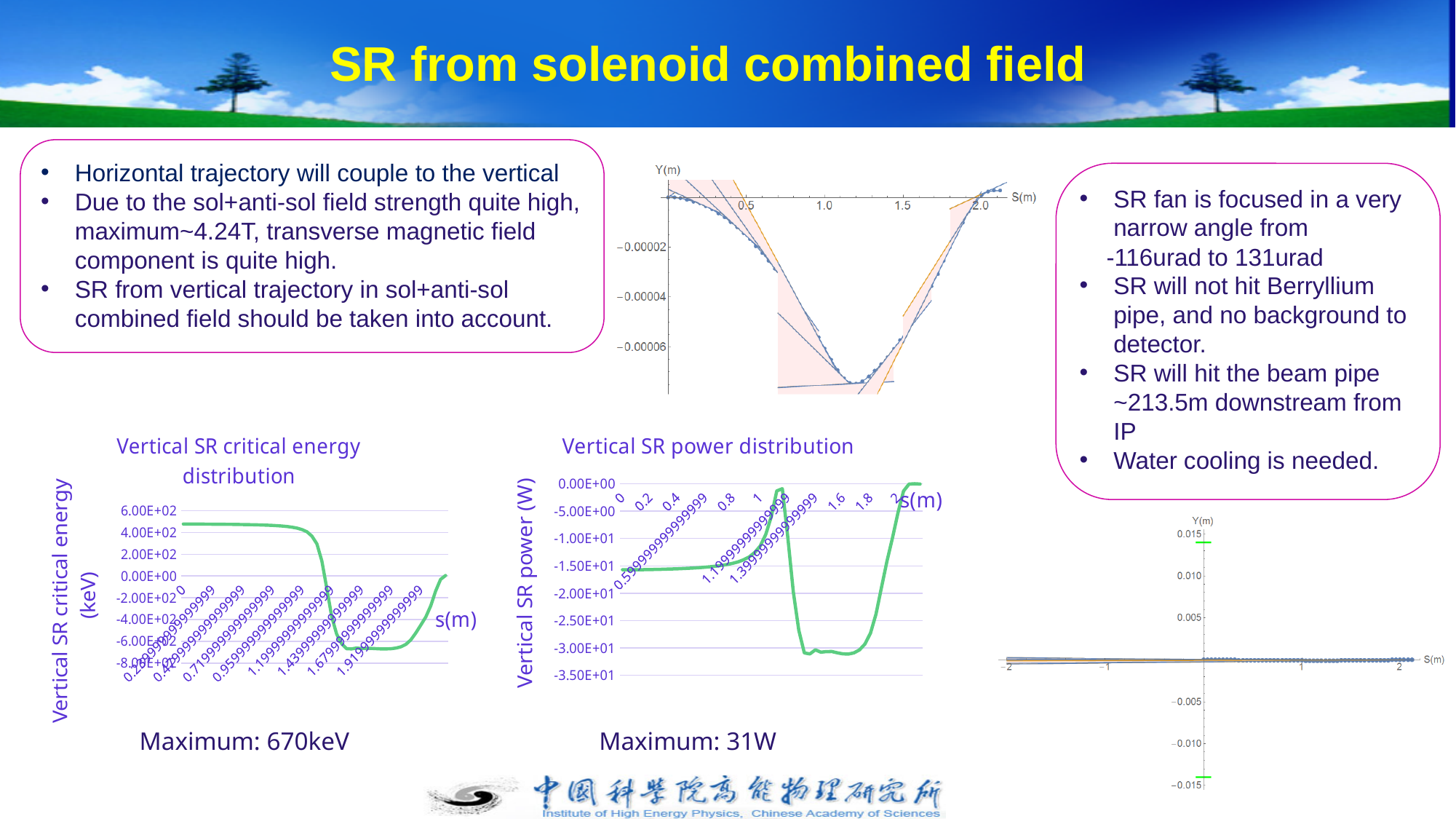
In the 'Vertical SR power distribution' chart, is the value at s = 0 greater or less than -1.00E+01? less In the 'Vertical SR power distribution' chart, is the lowest point of the curve greater or less than -3.00E+01? less In the 'Vertical SR critical energy distribution' chart, is the lowest point of the curve greater or less than -6.00E+02? less In the 'Vertical SR critical energy distribution' chart, does the curve rise or fall between s = 1.2 and s = 1.6? fall What maximum value is stated below the 'Vertical SR critical energy distribution' chart? 670keV What is the y-axis label of the 'Vertical SR power distribution' chart? Vertical SR power (W) What maximum value is stated below the 'Vertical SR power distribution' chart? 31W What is the title of the chart in the lower middle of the slide? Vertical SR power distribution What kind of chart is the 'Vertical SR critical energy distribution' chart? line chart In the 'Vertical SR power distribution' chart, does the curve rise or fall between s = 0 and s = 1.2? rise